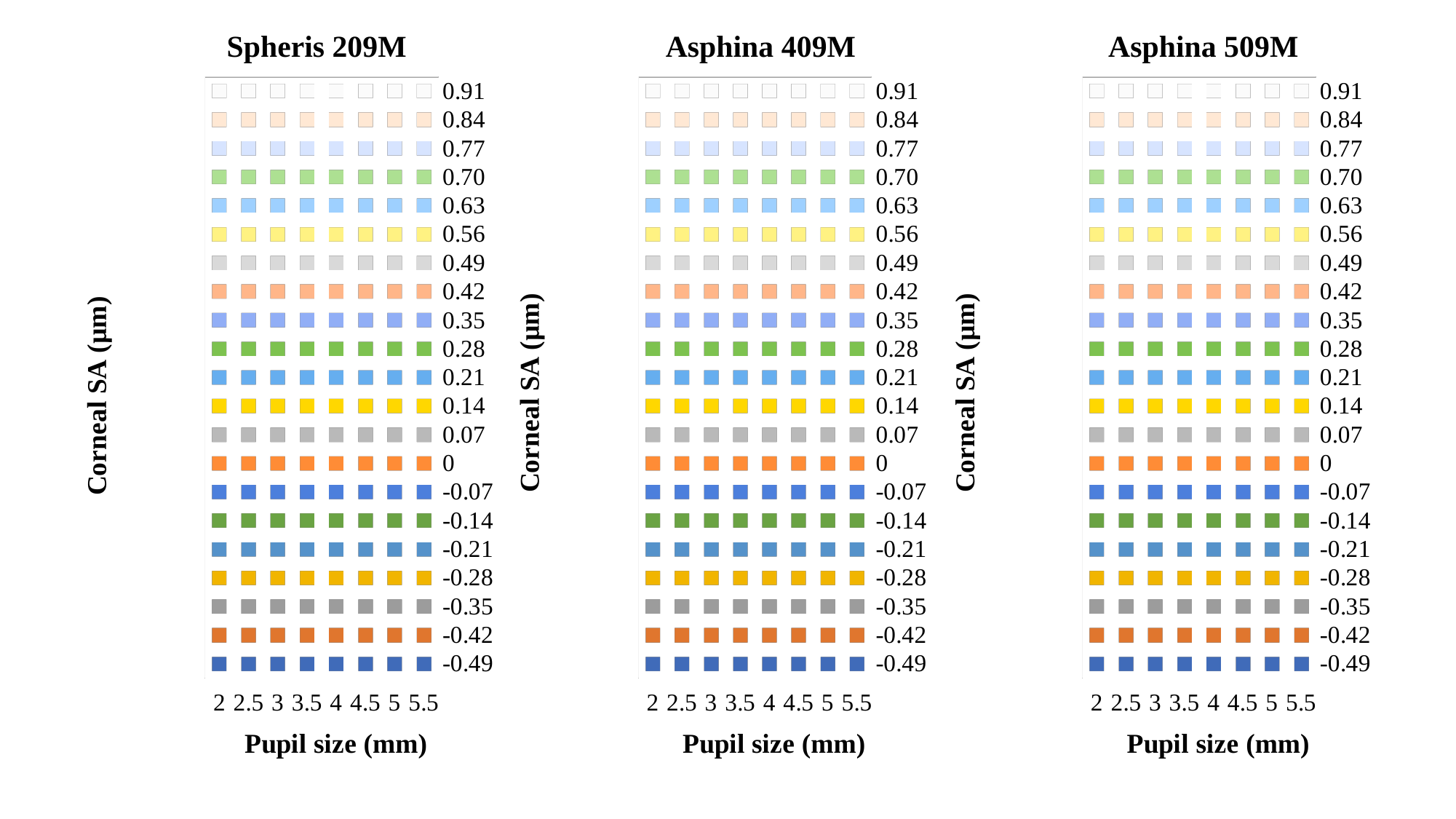
In the Asphina 409M chart, what is the smallest pupil size shown on the x axis? 2 In the Asphina 509M chart, what is the largest pupil size shown on the x axis? 5.5 In the Spheris 209M chart, how many pupil size values are listed along the x axis? 8 In the Spheris 209M chart, what is the smallest Corneal SA value labelled on the grid? -0.49 What is the title of the rightmost chart? Asphina 509M What is the title of the leftmost chart? Spheris 209M In the Spheris 209M chart, what is the difference between consecutive Corneal SA labels, such as 0.91 and 0.84? 0.07 In the Asphina 409M chart, how many rows of markers are plotted in the grid? 21 In the Asphina 409M chart, how many Corneal SA levels are listed along the right side of the grid? 21 In the Asphina 509M chart, what is the largest Corneal SA value labelled on the grid? 0.91